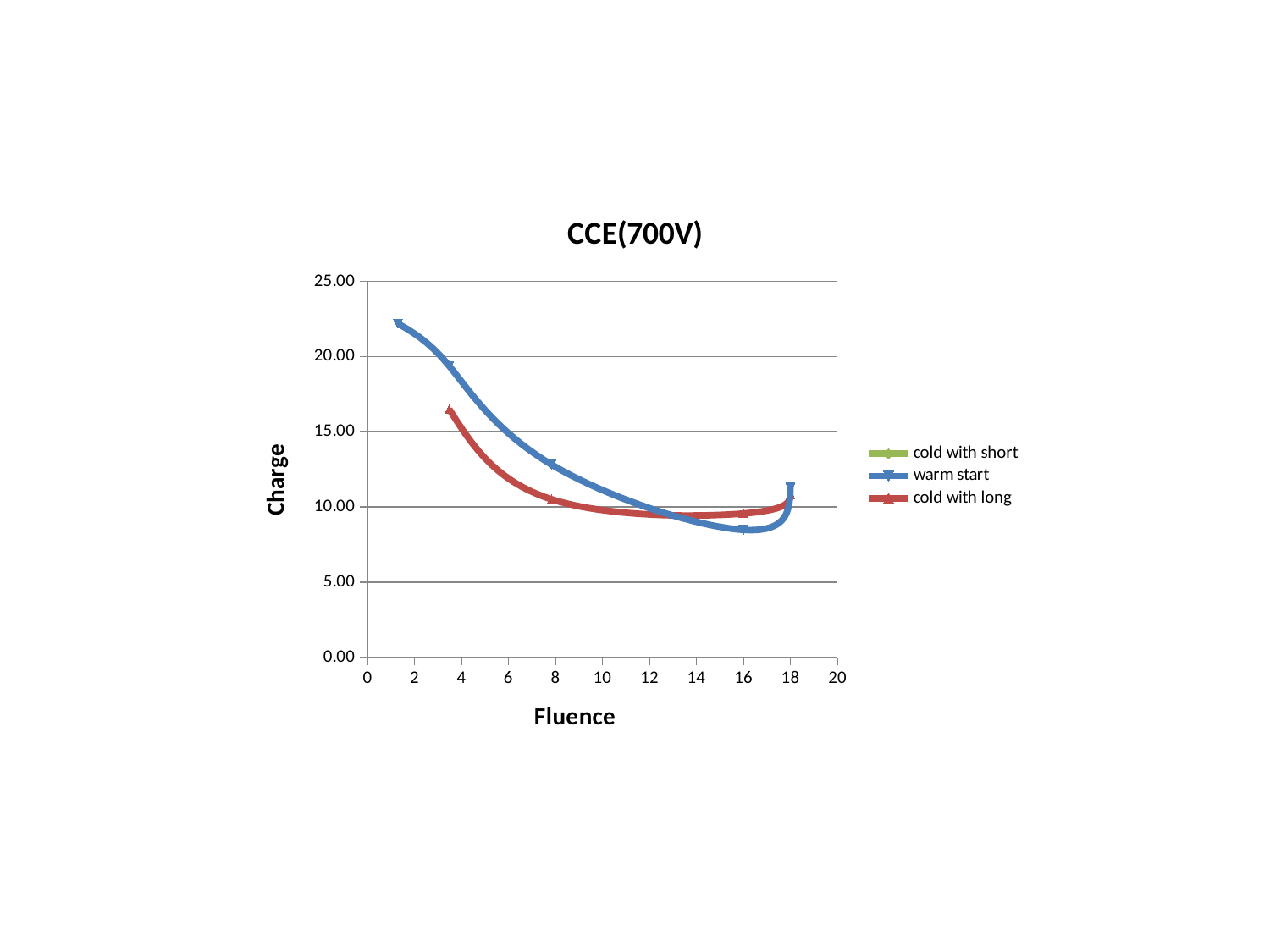
Does the warm start series mainly rise or fall as fluence increases from 1 to 16? fall Is the warm start value at fluence 16 greater or less than 10.00? less At fluence 16, which series has the larger charge, warm start or cold with long? cold with long Is the warm start value at fluence 8 greater or less than 10.00? greater What kind of chart is shown on the slide? line chart What is the label of the x axis? Fluence Is the first plotted value of the cold with long series (at fluence about 3.5) greater or less than 15.00? greater Which series reaches the highest charge value on the chart? warm start At fluence 8, which series has the larger charge, warm start or cold with long? warm start How many series does the legend list? 3 What is the title of the chart? CCE(700V)